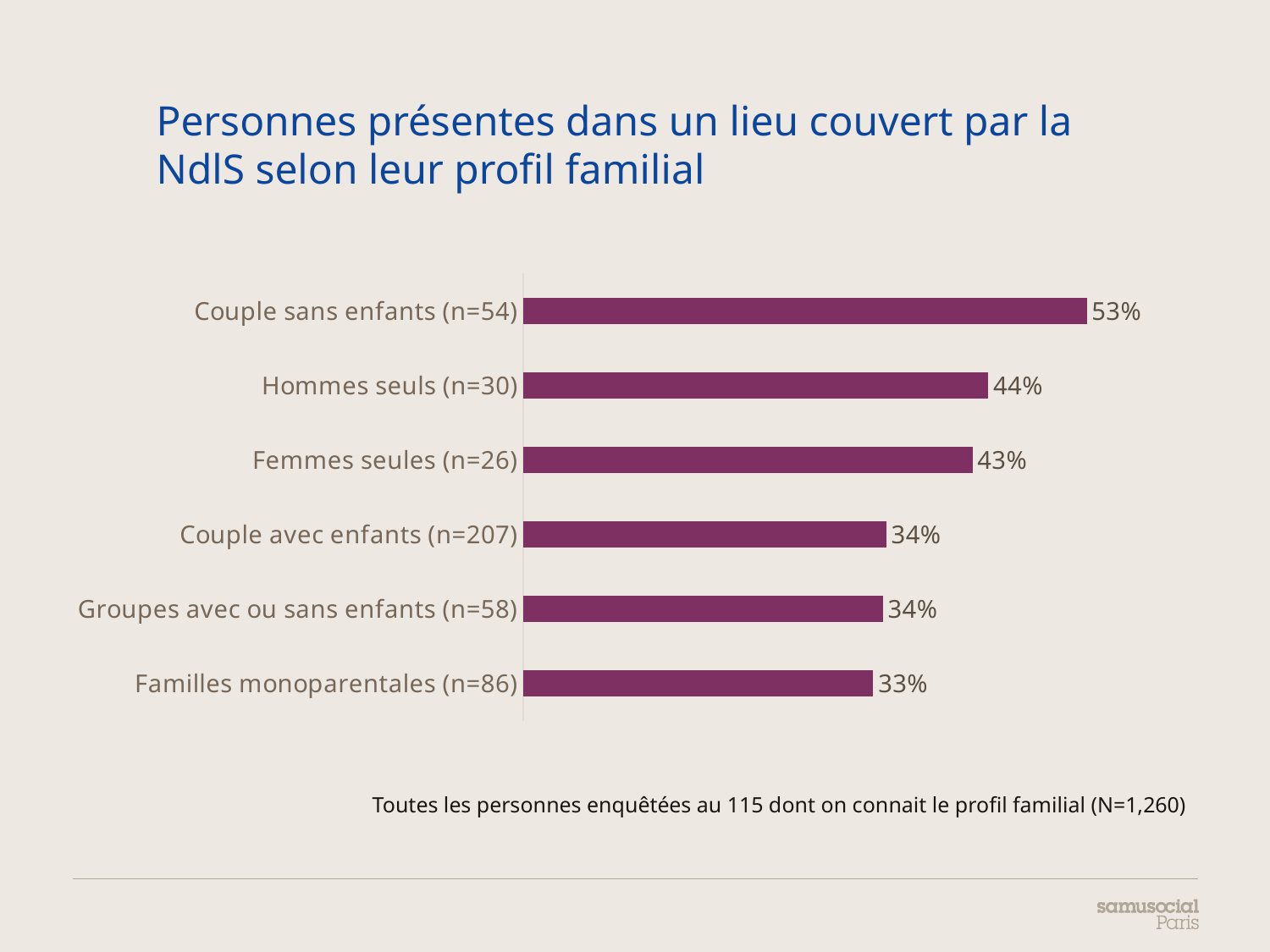
What is the difference between the values for Hommes seuls (n=30) and Couple avec enfants (n=207)? 10% What is the value for Femmes seules (n=26)? 43% Which category has the highest value? Couple sans enfants (n=54) What kind of chart is shown on the slide? Bar chart What is the difference between the values for Couple sans enfants (n=54) and Familles monoparentales (n=86)? 20% What is the title of the chart? Personnes présentes dans un lieu couvert par la NdlS selon leur profil familial What is the value for Couple sans enfants (n=54)? 53% How many categories are shown in the chart? 6 What is the value for Hommes seuls (n=30)? 44% Which category has the lowest value? Familles monoparentales (n=86) Which is larger, the value for Couple sans enfants (n=54) or the value for Hommes seuls (n=30)? Couple sans enfants (n=54) What is the value for Familles monoparentales (n=86)? 33%